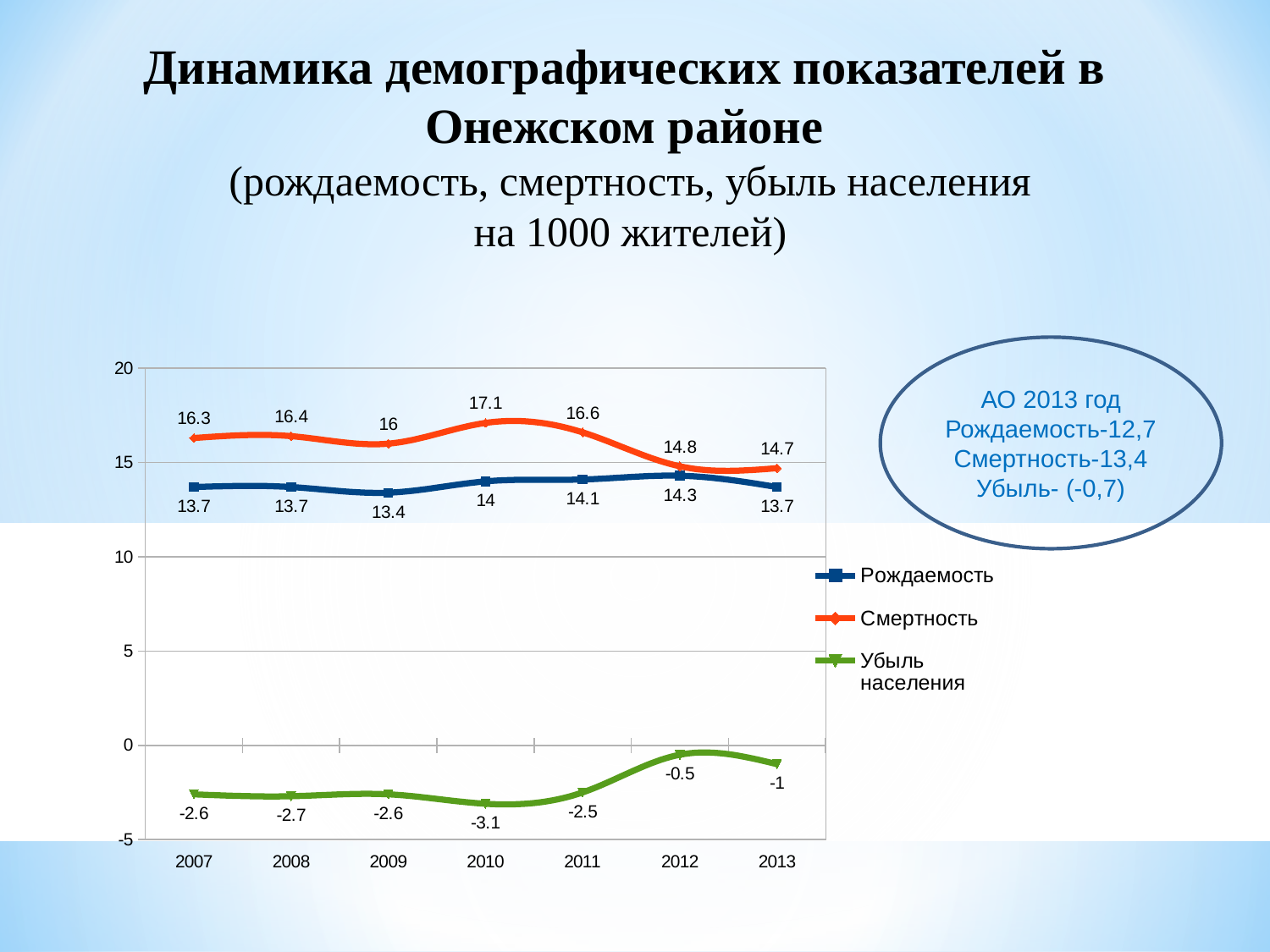
How many years are shown on the x axis? 7 What is the value of Рождаемость in 2012? 14.3 Which is larger in 2013: Смертность or Рождаемость? Смертность What is the value of Убыль населения in 2013? -1 What is the value of Смертность in 2010? 17.1 What is the difference between Смертность and Рождаемость in 2007? 2.6 How many series does the legend list? 3 In which year is Смертность highest? 2010 Which series is drawn in green? Убыль населения Does Смертность rise or fall from 2011 to 2013? Fall In which year is Рождаемость lowest? 2009 What kind of chart is shown on the slide? Line chart